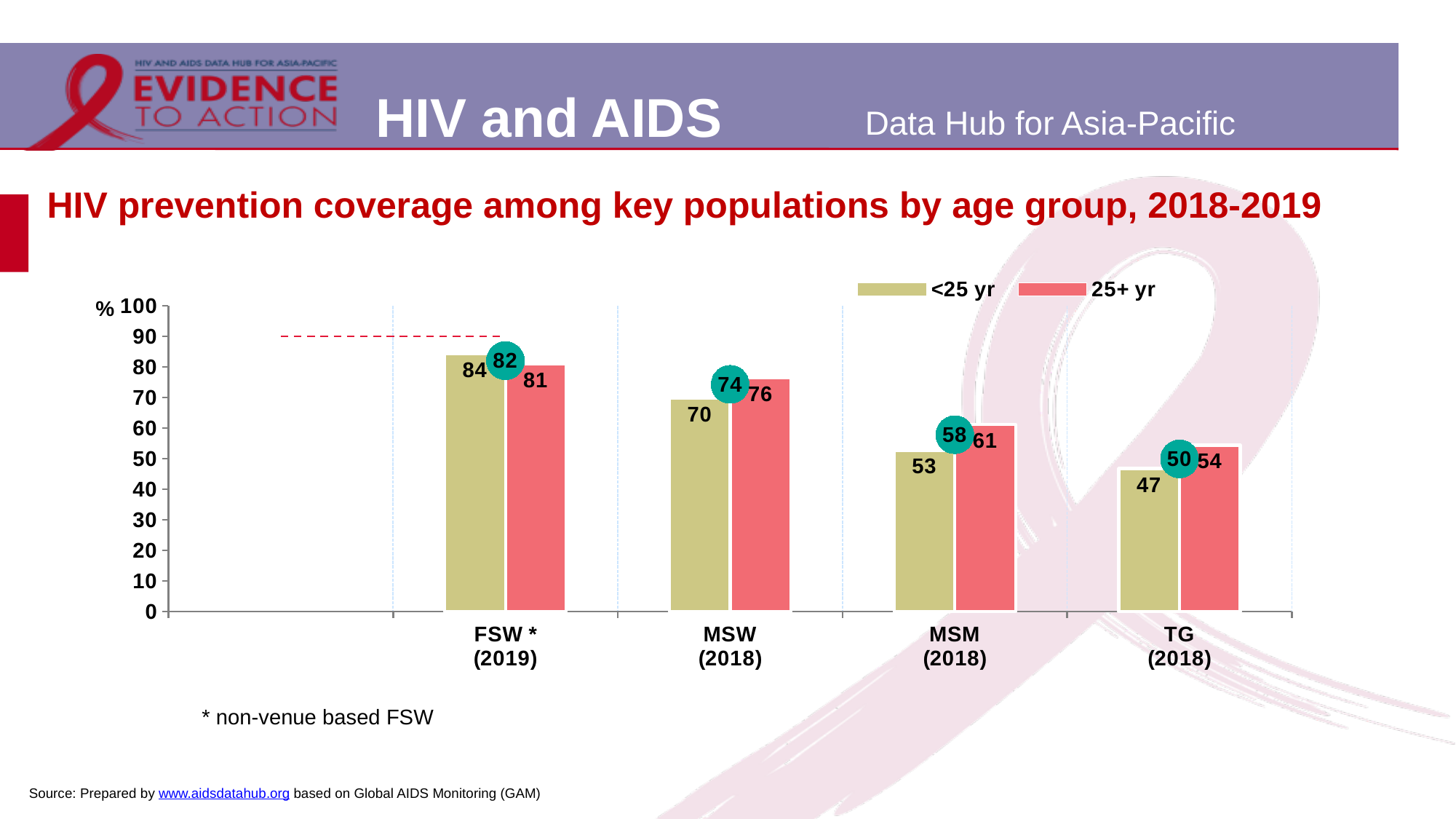
What is the HIV prevention coverage for FSW (2019) in the <25 yr group? 84 What is the difference between the 25+ yr and <25 yr coverage for MSM (2018)? 8 What is the HIV prevention coverage for MSM (2018) in the <25 yr group? 53 How many series does the legend list? 2 What is the HIV prevention coverage for MSW (2018) in the 25+ yr group? 76 What is the HIV prevention coverage for TG (2018) in the 25+ yr group? 54 For MSW (2018), which age group has the higher HIV prevention coverage? 25+ yr Which key population has the lowest HIV prevention coverage in the 25+ yr group? TG (2018) Which key population has the highest HIV prevention coverage in the <25 yr group? FSW * (2019) How many key population categories are shown on the x axis? 4 What kind of chart is shown on the slide? Bar chart Is the <25 yr coverage for TG (2018) greater or less than 50? less